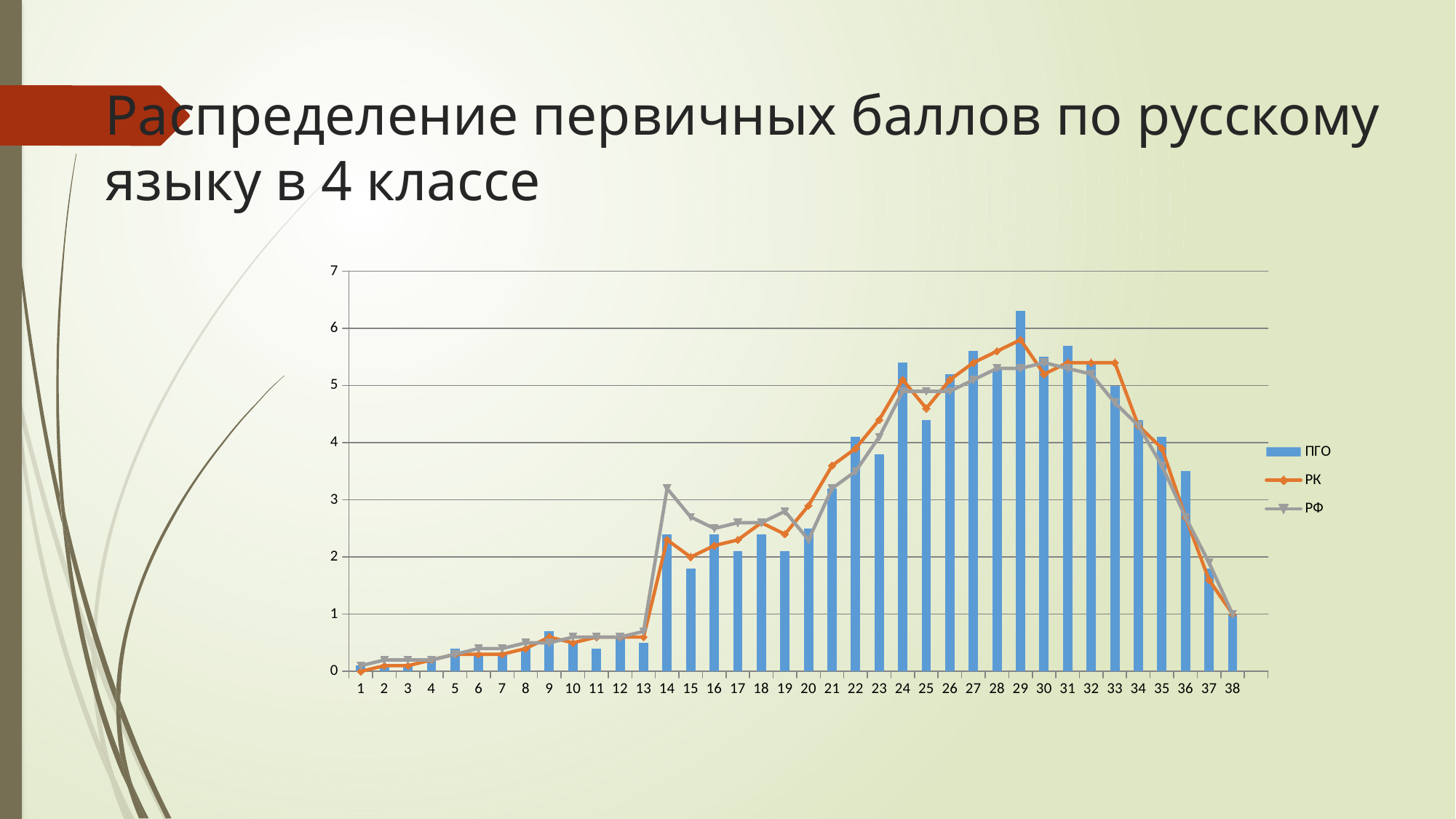
Is the ПГО value for category 15 greater or less than 2? less Is the ПГО value for category 36 greater or less than 3? greater Do the ПГО bars generally rise or fall from category 31 to category 38? fall How many series does the legend list? 3 Which category has the highest ПГО bar? 29 Which has the larger ПГО bar, category 22 or category 23? 22 What is the title of the slide containing the chart? Распределение первичных баллов по русскому языку в 4 классе How many categories are shown along the x axis? 38 What are the three series named in the legend? ПГО, РК, РФ What kind of chart is this? A bar chart (ПГО) combined with two line series (РК, РФ) Is the ПГО value for category 13 greater or less than 1? less